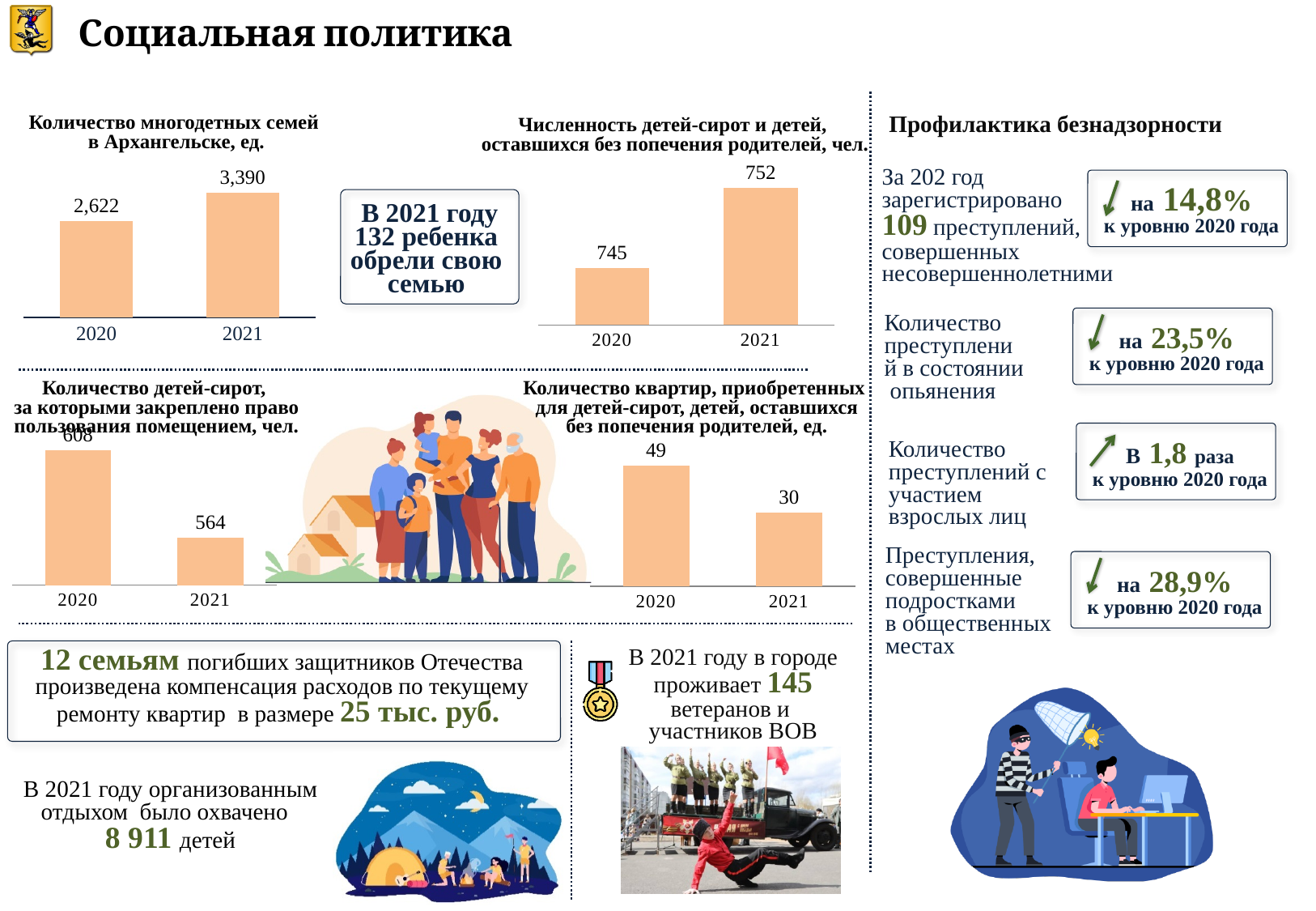
In the chart 'Количество многодетных семей в Архангельске, ед.', do the values rise or fall from 2020 to 2021? rise In the chart 'Количество квартир, приобретенных для детей-сирот, детей, оставшихся без попечения родителей, ед.', which year has the lower value? 2021 What type of chart is 'Количество многодетных семей в Архангельске, ед.'? bar chart In the chart 'Численность детей-сирот и детей, оставшихся без попечения родителей, чел.', what is the value for 2021? 752 In the chart 'Количество детей-сирот, за которыми закреплено право пользования помещением, чел.', what is the value for 2021? 564 In the chart 'Численность детей-сирот и детей, оставшихся без попечения родителей, чел.', which year has the higher value? 2021 In the chart 'Численность детей-сирот и детей, оставшихся без попечения родителей, чел.', what is the difference between the 2021 and 2020 values? 7 In the chart 'Количество квартир, приобретенных для детей-сирот, детей, оставшихся без попечения родителей, ед.', what is the value for 2020? 49 In the chart 'Количество многодетных семей в Архангельске, ед.', what is the value for 2020? 2,622 In the chart 'Количество детей-сирот, за которыми закреплено право пользования помещением, чел.', do the values rise or fall from 2020 to 2021? fall In the chart 'Количество квартир, приобретенных для детей-сирот, детей, оставшихся без попечения родителей, ед.', what is the difference between the 2020 and 2021 values? 19 In the chart 'Количество многодетных семей в Архангельске, ед.', what is the value for 2021? 3,390